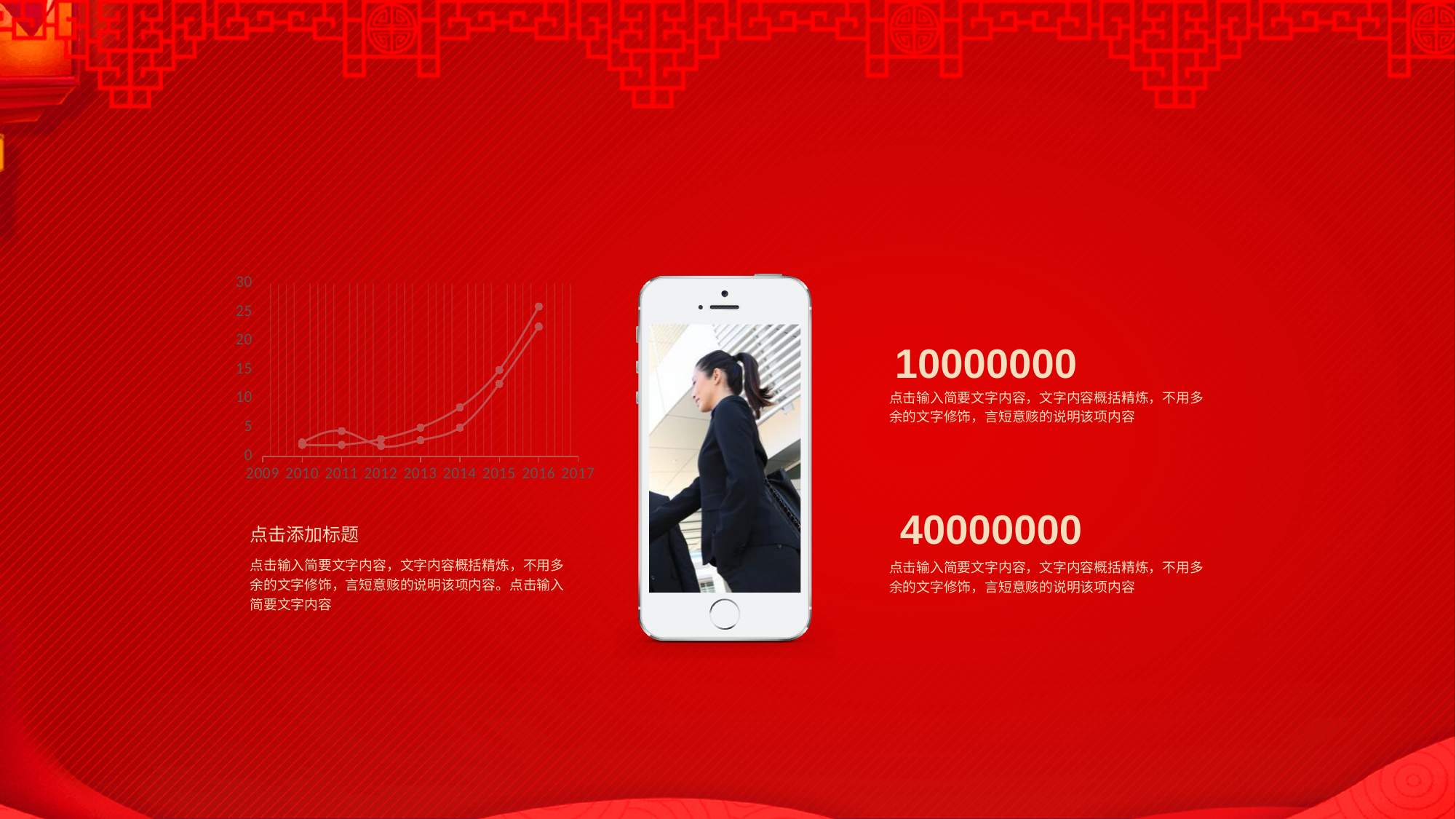
How many year labels appear on the x axis of the chart? 9 What is the first year label on the x axis of the chart? 2009 Is the value of the upper line for 2010 greater or less than 5? less What is the last year label on the x axis of the chart? 2017 Which year has the larger value on the upper line, 2014 or 2015? 2015 Is the value of the lower line for 2015 greater or less than 10? greater Is the value of the lower line for 2016 greater or less than 20? greater What is the highest value shown on the y axis of the chart? 30 What kind of chart is shown on the left of the slide? line chart In which year do the lines in the chart reach their highest point? 2016 Do the values in the chart generally rise or fall from 2010 to 2016? rise How many lines are plotted in the chart? 2